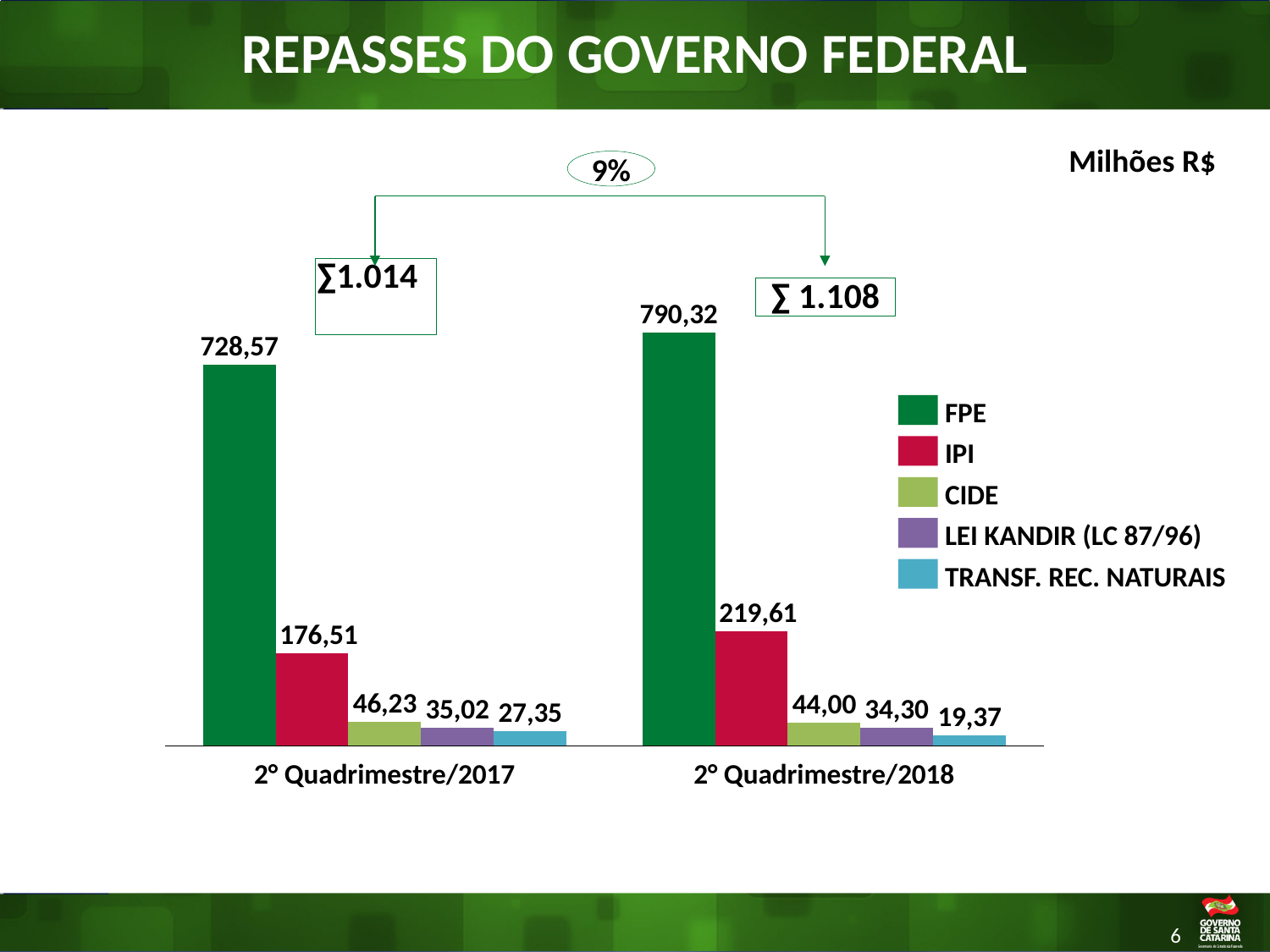
Which series has the lowest value in 2º Quadrimestre/2017? TRANSF. REC. NATURAIS What is the title of the slide containing the chart? REPASSES DO GOVERNO FEDERAL What is the difference between the IPI values for 2º Quadrimestre/2018 and 2º Quadrimestre/2017? 43,10 How many series does the legend list? 5 What is the value for TRANSF. REC. NATURAIS in 2º Quadrimestre/2018? 19,37 What kind of chart is shown on the slide? Bar chart What is the value for IPI in 2º Quadrimestre/2018? 219,61 What is the value for FPE in 2º Quadrimestre/2017? 728,57 Which is larger: CIDE in 2º Quadrimestre/2017 or CIDE in 2º Quadrimestre/2018? CIDE in 2º Quadrimestre/2017 What is the difference between the FPE values for 2º Quadrimestre/2018 and 2º Quadrimestre/2017? 61,75 What is the value for LEI KANDIR (LC 87/96) in 2º Quadrimestre/2017? 35,02 Which series has the highest value in 2º Quadrimestre/2018? FPE